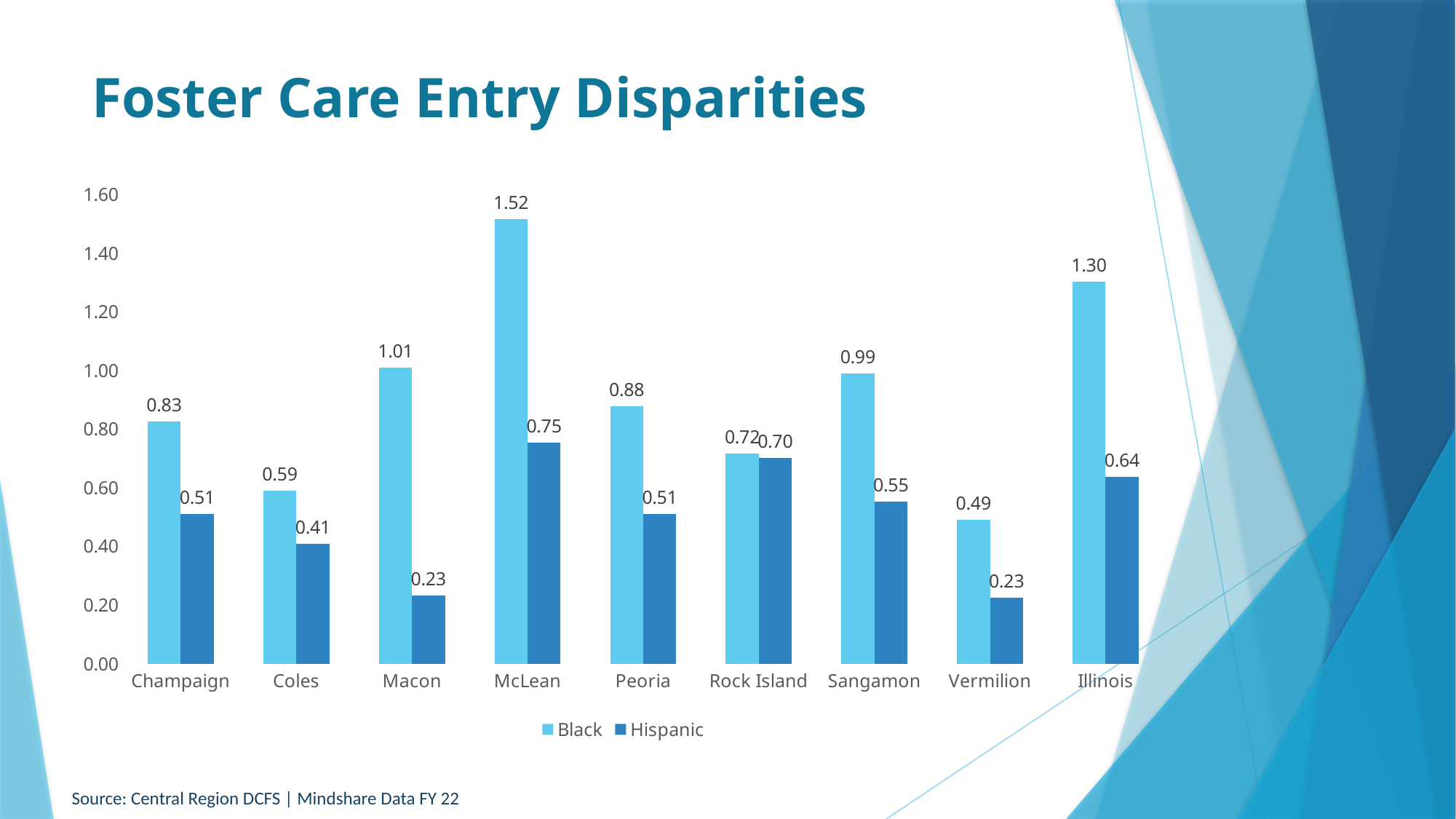
What is the difference between the Black and Hispanic values for Macon? 0.78 How many categories are shown on the x axis? 9 How many series does the legend list? 2 Which series is shown in the darker blue colour? Hispanic Which category has the lowest Black value? Vermilion What is the Black value for McLean? 1.52 Which category has the highest Black value? McLean What is the Hispanic value for Illinois? 0.64 Which is larger, the Black value for Sangamon or the Black value for Peoria? Sangamon What kind of chart is shown on the slide? Bar chart What is the title of the slide? Foster Care Entry Disparities What is the Hispanic value for Macon? 0.23